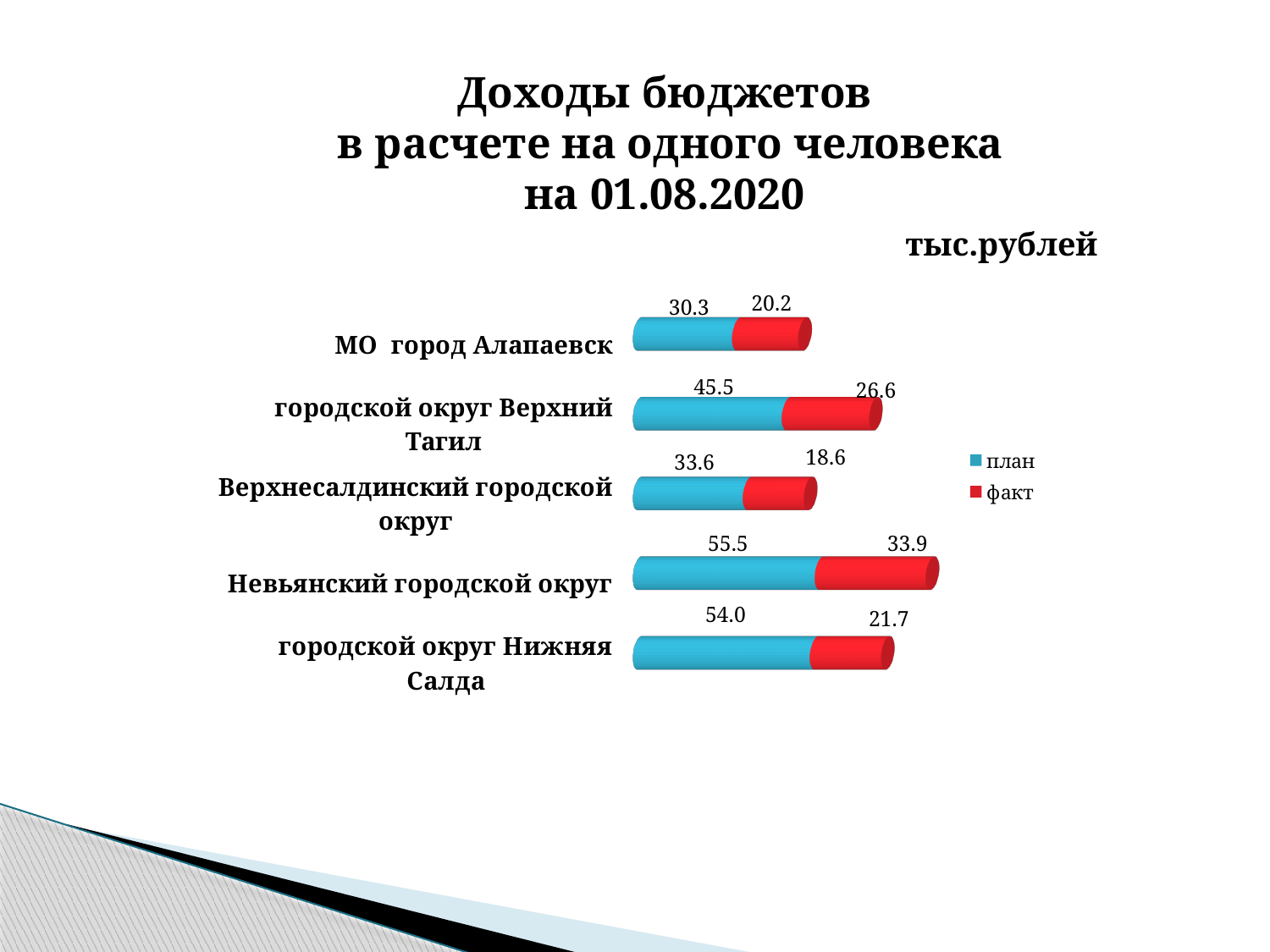
What kind of chart is shown on the slide? Stacked bar chart Which category has the lowest факт value? Верхнесалдинский городской округ What is the факт value for МО город Алапаевск? 20.2 What is the difference between the план and факт values for городской округ Нижняя Салда? 32.3 Which is larger: the факт value for Невьянский городской округ or the факт value for городской округ Нижняя Салда? Невьянский городской округ How many categories are shown in the chart? 5 What is the факт value for городской округ Верхний Тагил? 26.6 What is the total of the stacked bar for Верхнесалдинский городской округ? 52.2 What unit is indicated above the chart? тыс.рублей How many series does the legend list? 2 What is the план value for Невьянский городской округ? 55.5 Which category has the highest план value? Невьянский городской округ